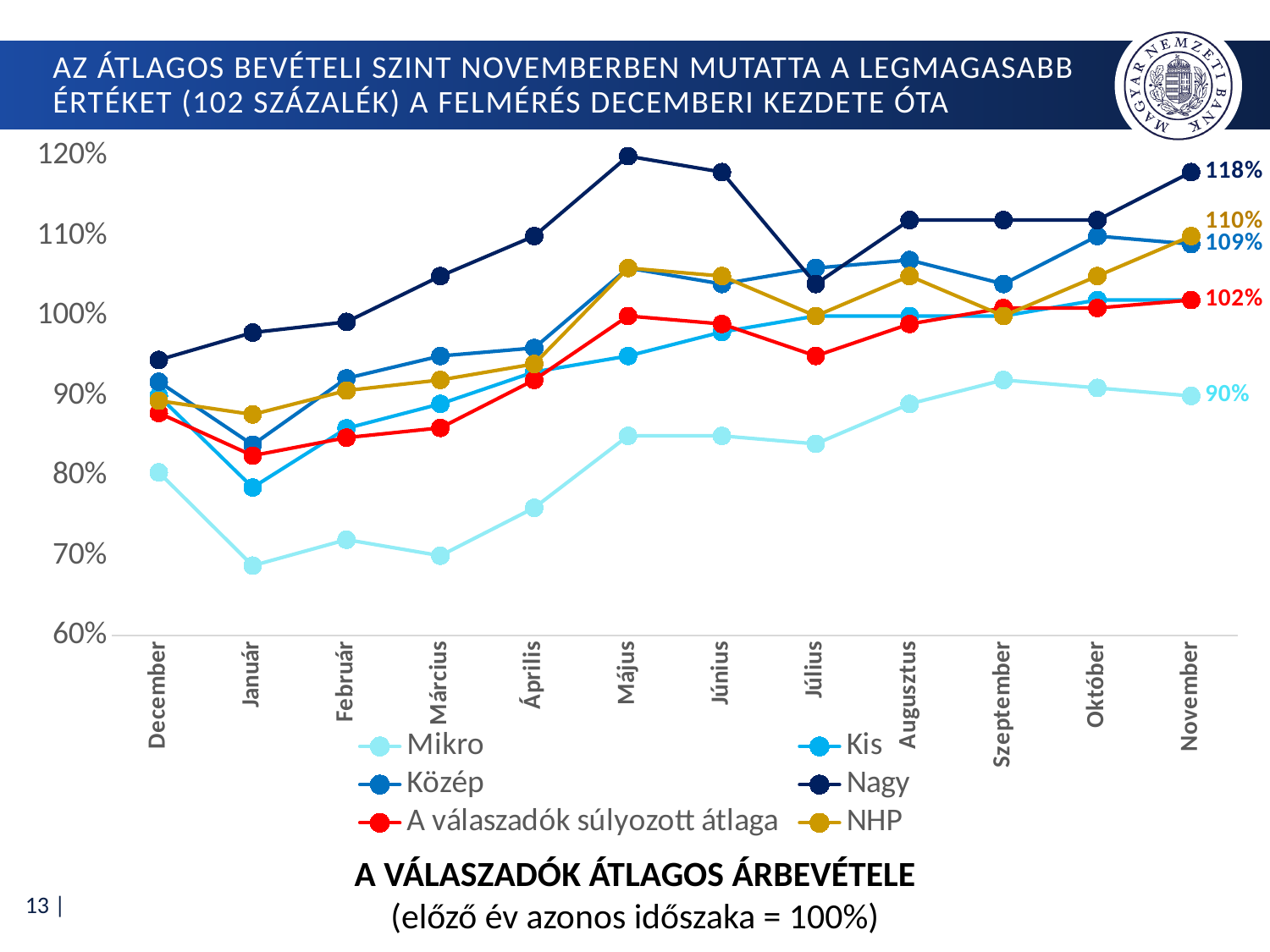
How many series does the legend list? 6 Is the value for Mikro in Január greater or less than 70%? less What is the value for 'A válaszadók súlyozott átlaga' in November? 102% What kind of chart is shown on the slide? Line chart In November, which is larger: the Nagy value or the NHP value? Nagy Which series has the lowest value in November? Mikro Which series has the highest value in November? Nagy What is the value for the Mikro series in November? 90% What is the value for the NHP series in November? 110% What is the value for the Nagy series in November? 118% Is the value for Nagy in Május greater or less than 110%? greater What is the difference between the Nagy and Mikro values in November? 28 percentage points